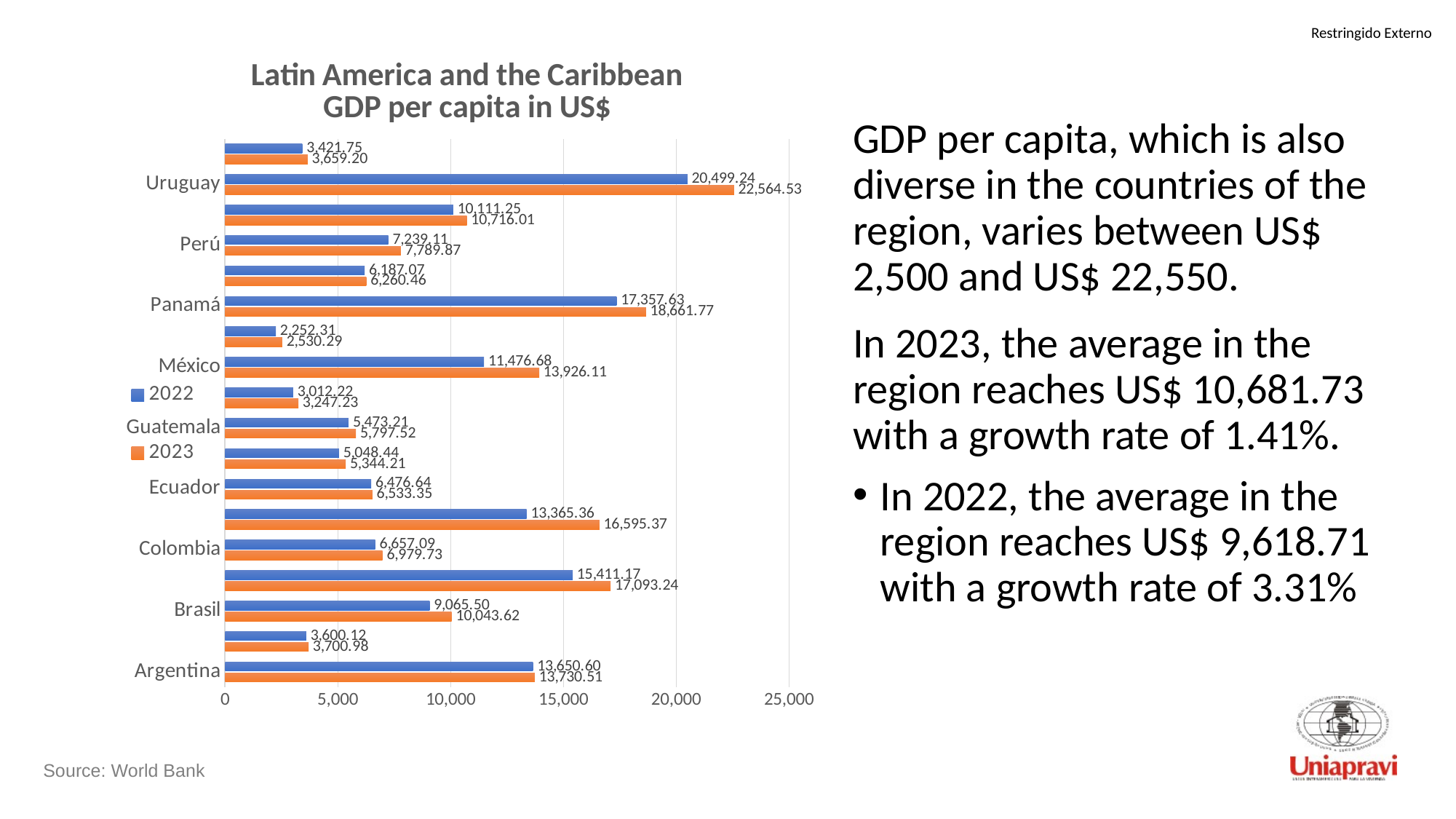
Is the 2022 value for Argentina greater or less than 10,000? greater What is the 2023 GDP per capita for México? 13,926.11 Which had the higher 2023 GDP per capita, Colombia or Ecuador? Colombia How many series does the legend list? 2 By how much did Brasil's GDP per capita increase from 2022 to 2023? 978.12 By how much did Panamá's GDP per capita increase from 2022 to 2023? 1,304.14 Among the labelled countries, which has the highest 2023 GDP per capita? Uruguay Among the labelled countries, which has the lowest 2023 GDP per capita? Guatemala What is the 2022 GDP per capita for Perú? 7,239.11 What kind of chart is shown on the slide? Bar chart What is the 2023 GDP per capita for Uruguay? 22,564.53 What is the 2022 GDP per capita for Brasil? 9,065.50